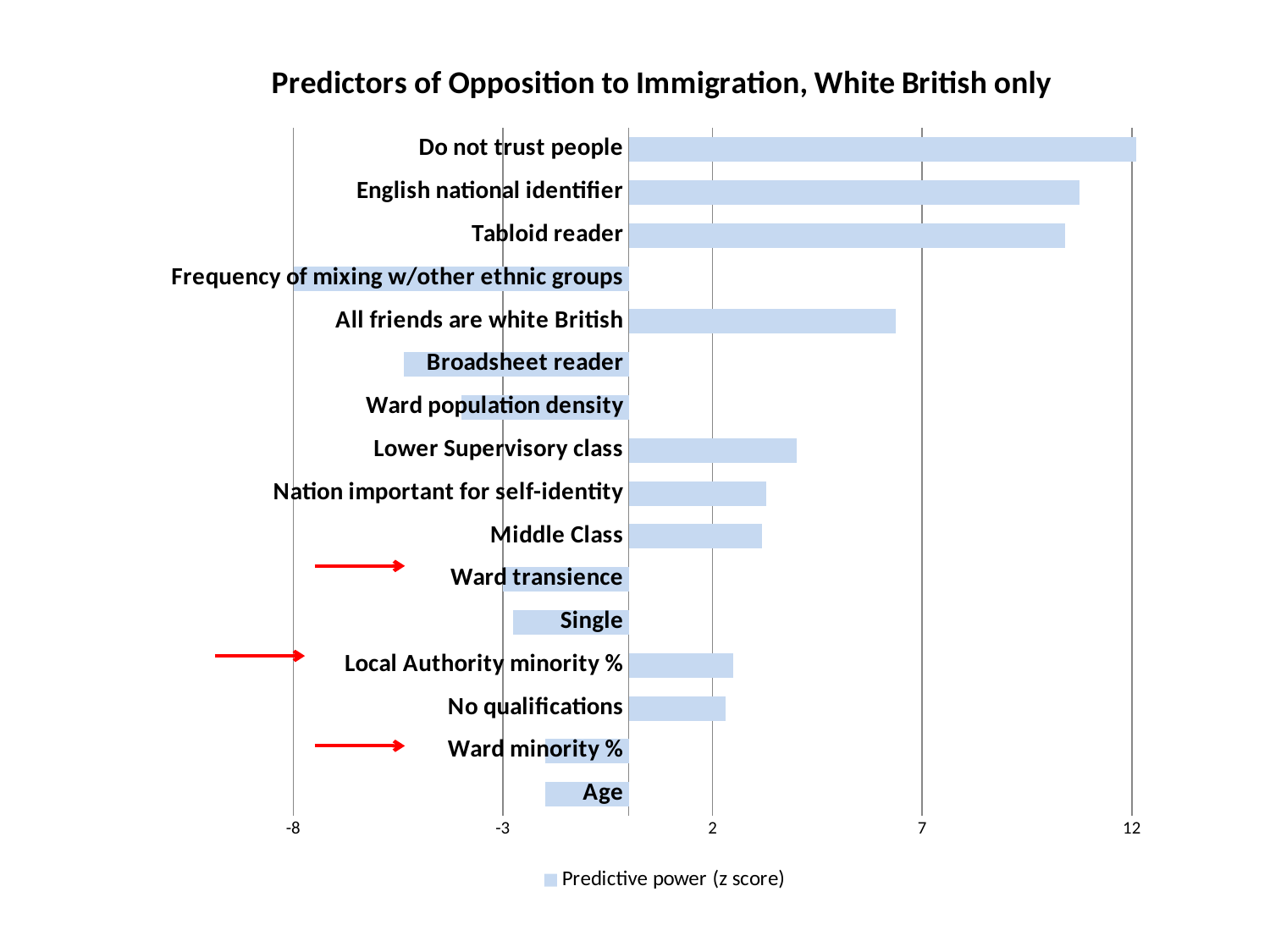
How many predictors (categories) are plotted in the chart? 16 What type of chart is shown on the slide? Bar chart Which predictor has the highest predictive power (z score)? Do not trust people Is the value for Tabloid reader greater or less than 7? greater How many series does the legend list? 1 What is the title of the chart? Predictors of Opposition to Immigration, White British only Which predictor has the lowest (most negative) predictive power (z score)? Frequency of mixing w/other ethnic groups Which has the larger value, Tabloid reader or All friends are white British? Tabloid reader Which has the larger value, Lower Supervisory class or Middle Class? Lower Supervisory class Is the value for All friends are white British greater or less than 2? greater Is the value for Broadsheet reader greater or less than -3? less